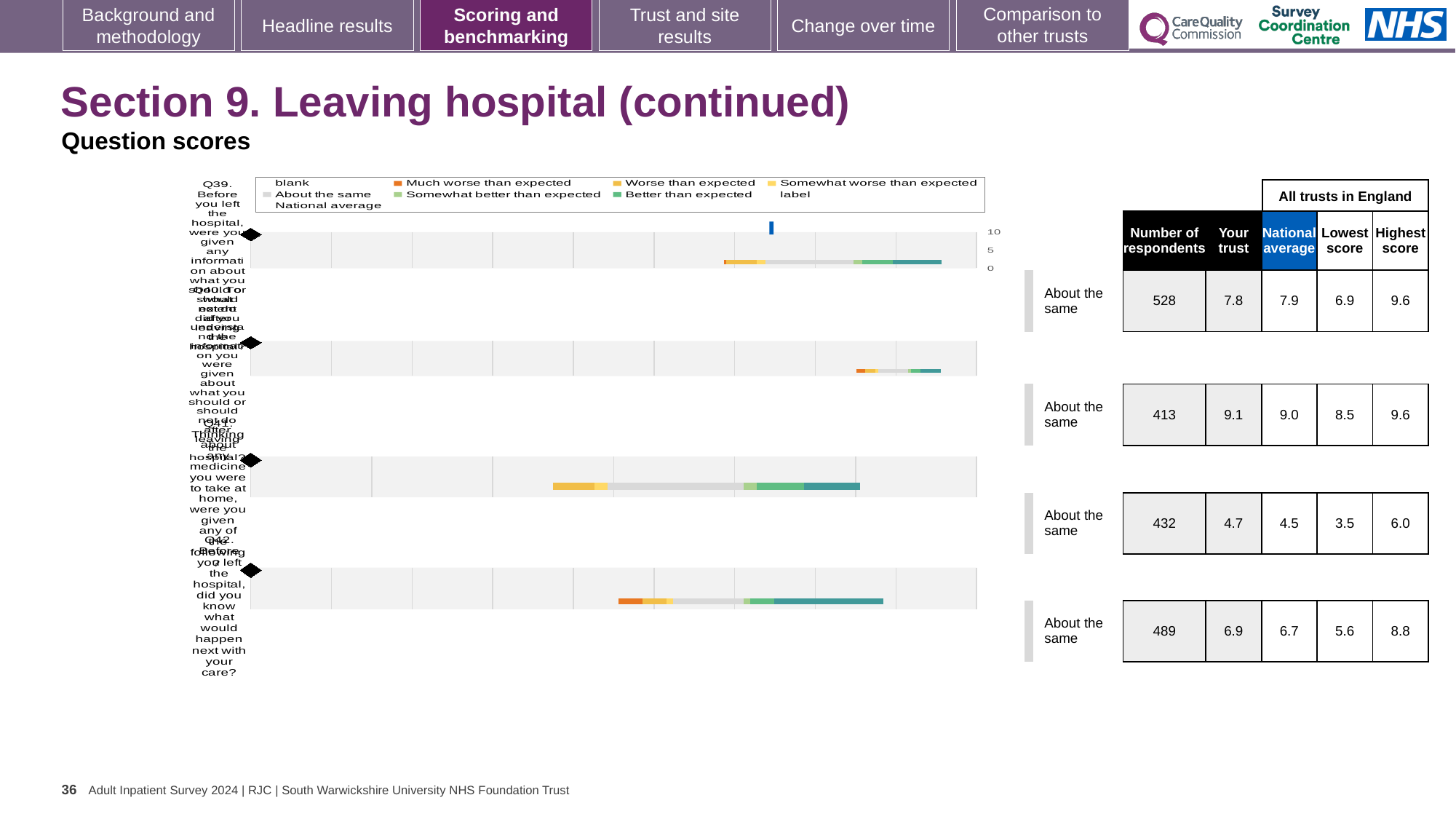
What is the highest tick value shown on the chart axis? 10 In the table beside the charts, for the first question (Q39), which is larger: the 'Your trust' score or the 'National average'? National average How many entries does the chart legend list? 9 In the table beside the charts, what is the 'Your trust' score for the first question (Q39)? 7.8 In the table beside the charts, which row has the lowest 'Your trust' score? the third row (4.7) What kind of chart is used to show the question scores on this slide? bar chart In the table beside the charts, what is the difference between the highest score (6.0) and the lowest score (3.5) for the third question? 2.5 In the table beside the charts, which row has the highest 'Your trust' score? the second row (9.1) In the table beside the charts, what is the number of respondents for the first question (Q39)? 528 What benchmark label is shown next to each of the four bar panels? About the same How many separate bar panels (questions) are plotted on the slide? 4 What colour does the legend use for 'Much worse than expected'? orange